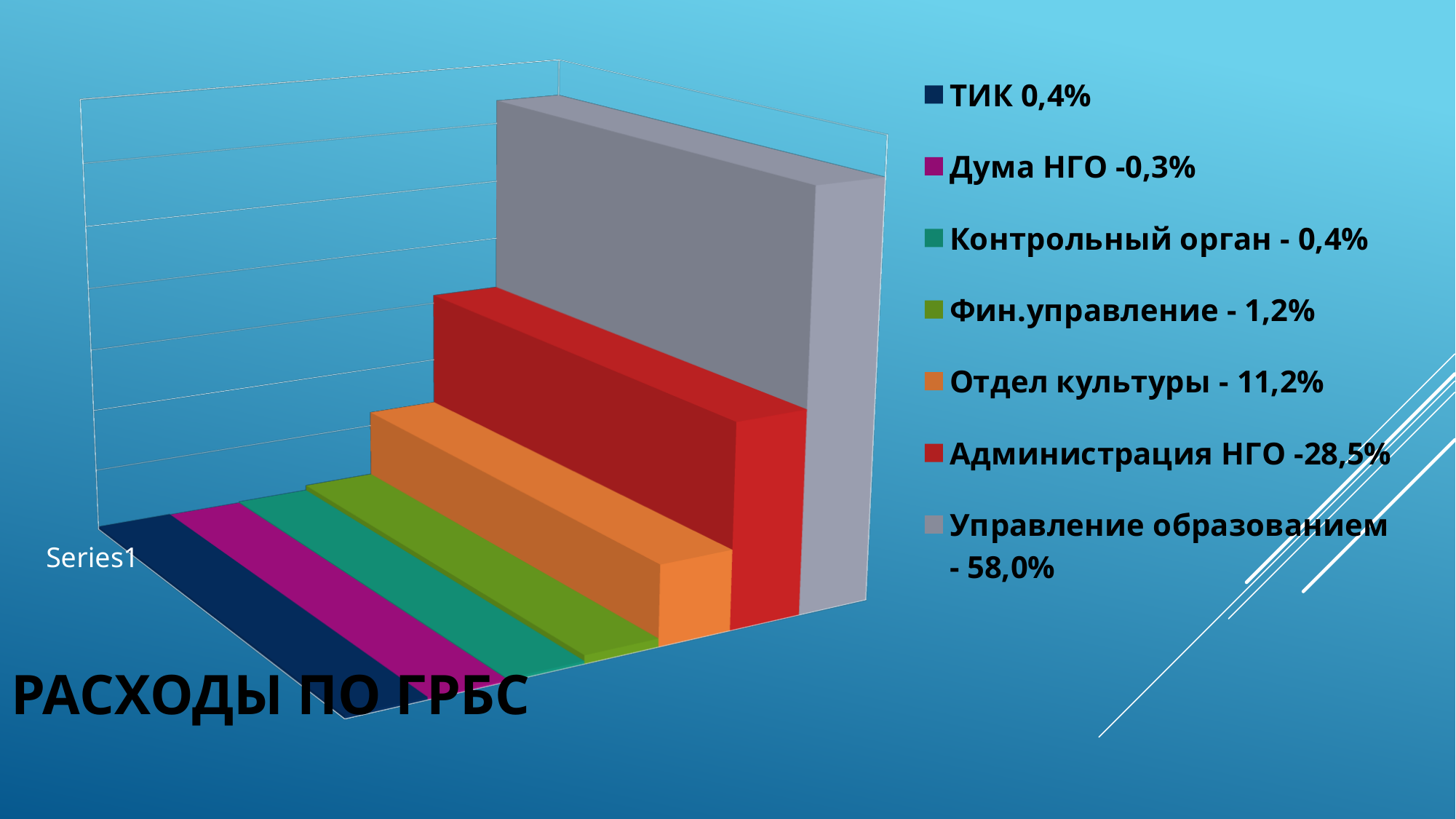
What share is shown for Отдел культуры in the legend? 11,2% What is the difference between the shares of Управление образованием and Администрация НГО? 29,5% How many categories does the legend list? 7 What is the title of the chart? РАСХОДЫ ПО ГРБС Which category has the highest share? Управление образованием Which category has the lowest share? Дума НГО What share is shown for Фин.управление in the legend? 1,2% Which is larger, the share of Отдел культуры or the share of Фин.управление? Отдел культуры What share is shown for Дума НГО in the legend? 0,3% What kind of chart is shown on the slide? 3D area chart What share is shown for Администрация НГО in the legend? 28,5% What share is shown for Управление образованием in the legend? 58,0%